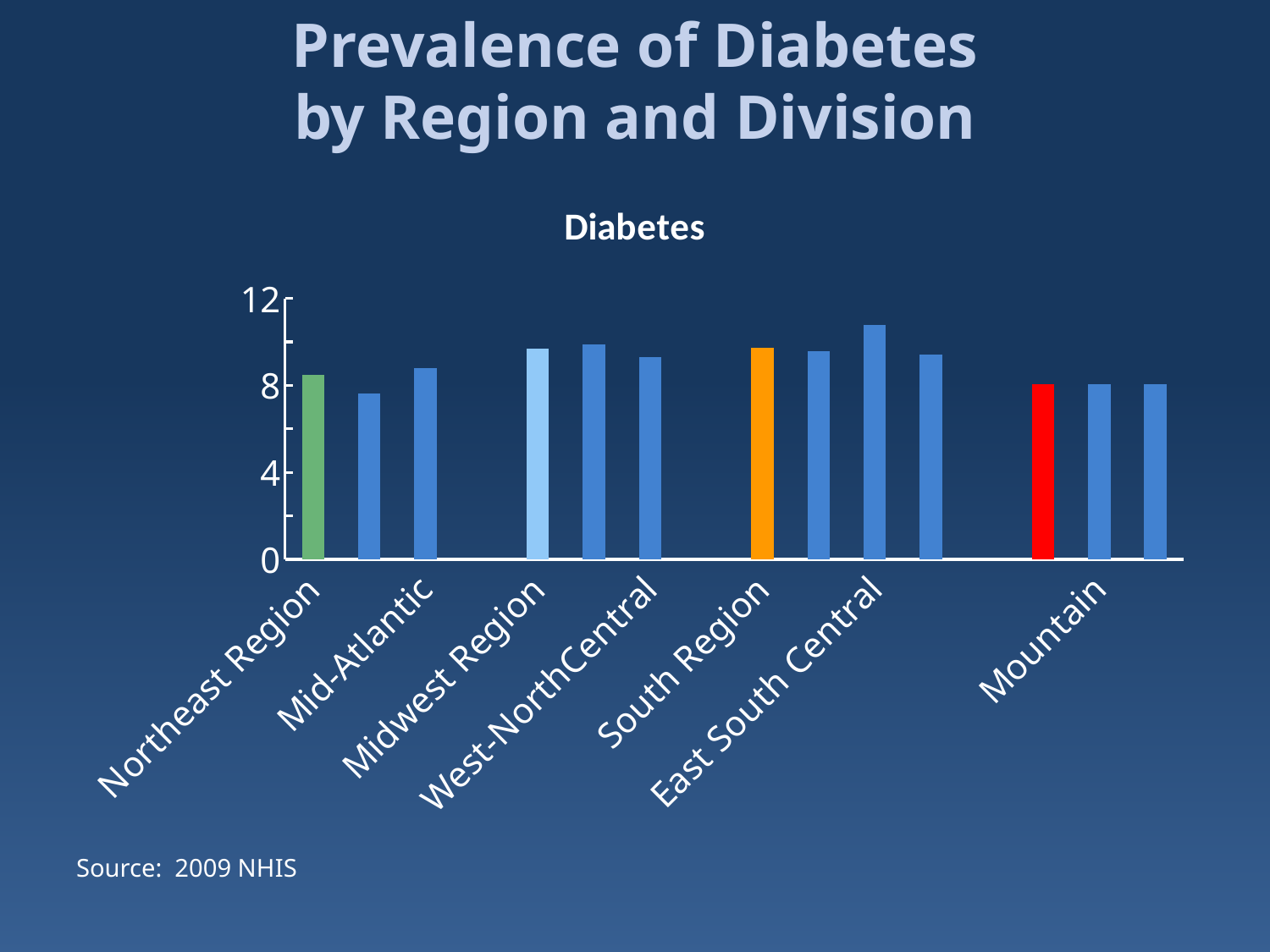
Is the value for Midwest Region greater or less than 12? less How many bars are plotted in the chart? 13 Which is larger, the value for South Region or the value for Mid-Atlantic? South Region What colour is the bar for Northeast Region? Green Is the value for West-NorthCentral greater or less than 4? greater What is the title shown above the chart? Diabetes Which is larger, the value for Midwest Region or the value for Northeast Region? Midwest Region Is the value for Northeast Region greater or less than 8? greater Which labelled category has the highest diabetes prevalence? East South Central What kind of chart is shown on the slide? Bar chart Which is larger, the value for East South Central or the value for Mountain? East South Central